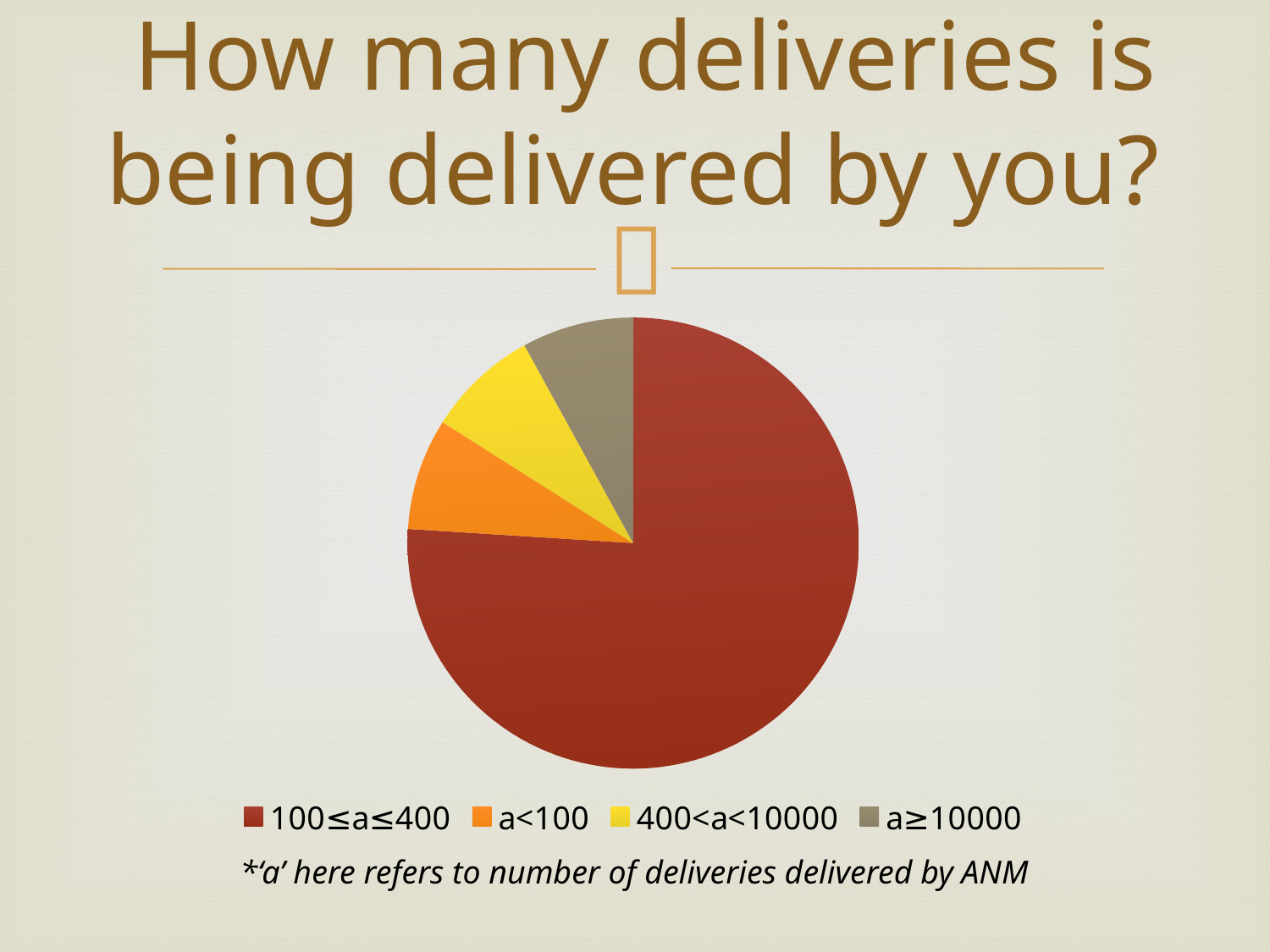
Which slice is larger, 100≤a≤400 or a≥10000? 100≤a≤400 Which category has the largest slice in the pie chart? 100≤a≤400 How many slices does the pie chart have? 4 What colour is the slice for a<100 in the pie chart? orange What kind of chart is shown on the slide? pie chart Which slice is larger, 400<a<10000 or 100≤a≤400? 100≤a≤400 How many entries does the legend of the pie chart list? 4 Which slice is larger, 100≤a≤400 or a<100? 100≤a≤400 Does the 100≤a≤400 slice take up more or less than half of the pie? more What is the title of the chart on the slide? How many deliveries is being delivered by you?